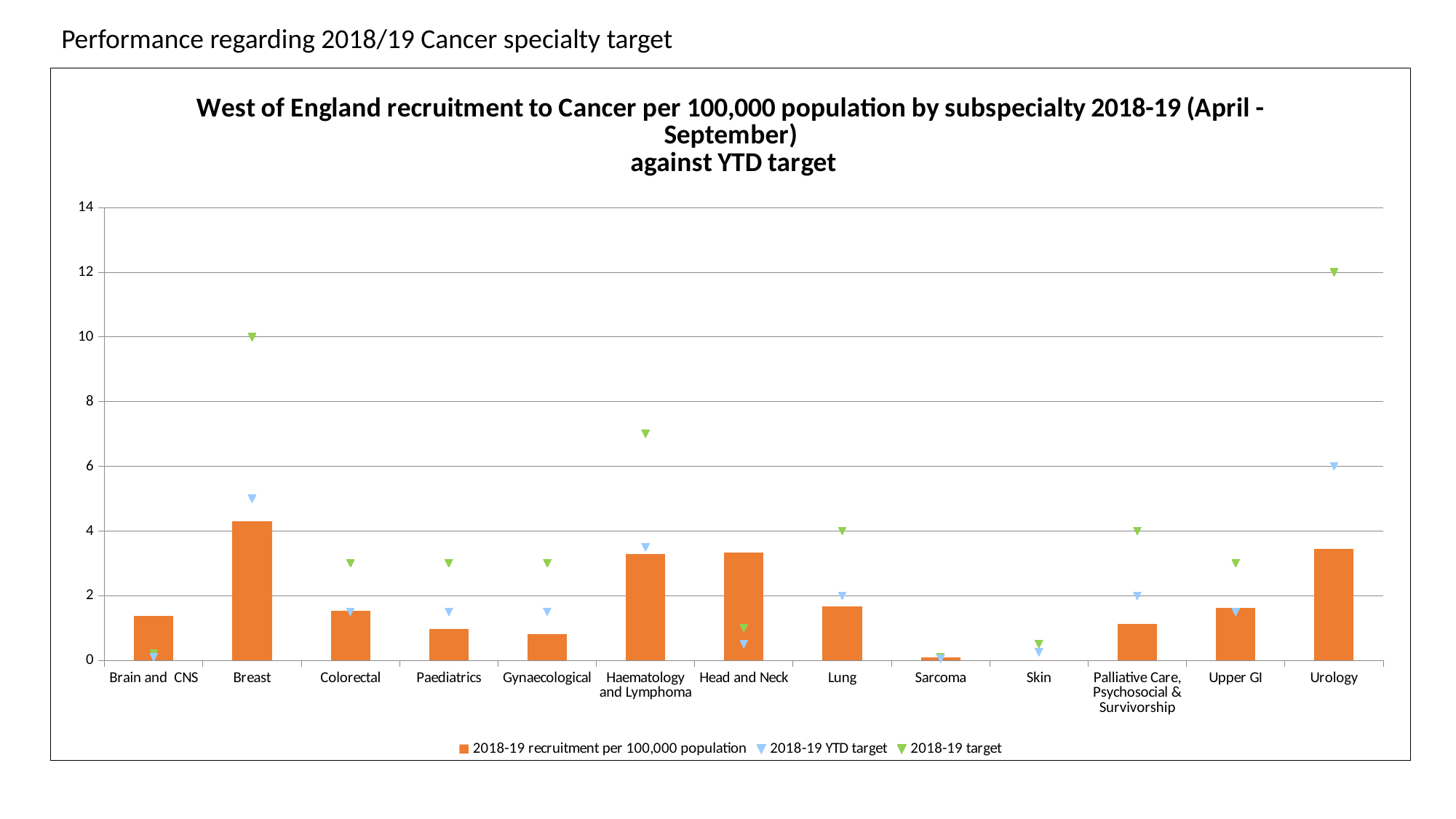
Which subspecialty has the highest 2018-19 recruitment per 100,000 population? Breast What is the 2018-19 target for Urology? 12 Which has the larger 2018-19 recruitment per 100,000 population, Colorectal or Paediatrics? Colorectal Is the 2018-19 recruitment per 100,000 population for Breast greater or less than 4? greater What is the 2018-19 target for Breast? 10 What is the 2018-19 YTD target for Urology? 6 Which series is shown with green triangle markers in the legend? 2018-19 target How many series does the legend list? 3 Is the 2018-19 recruitment per 100,000 population for Lung greater or less than 2? less How many subspecialty categories are shown on the x axis? 13 What kind of chart is shown on the slide? Bar chart What is the 2018-19 target for Lung? 4